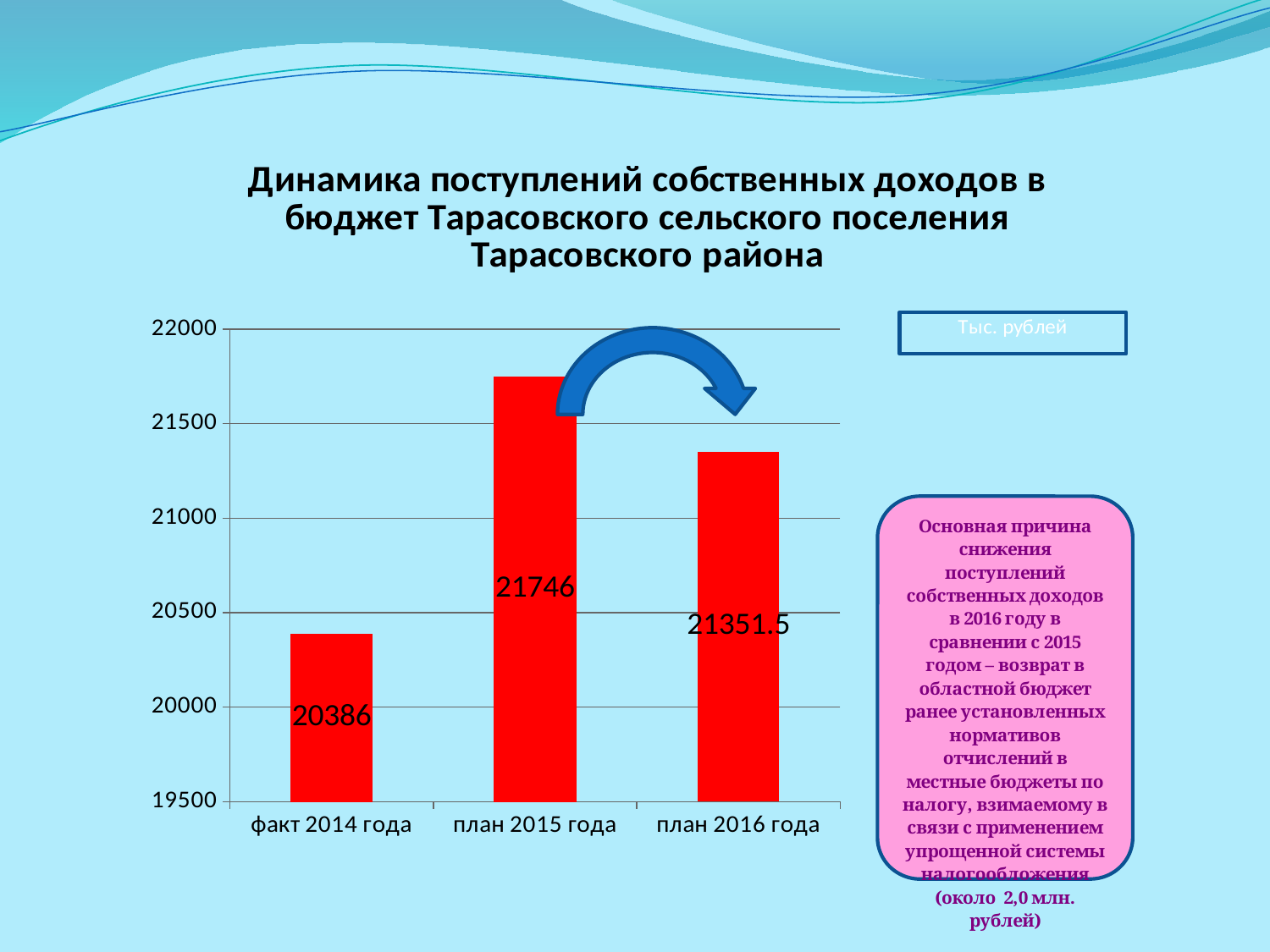
What unit of measurement is indicated for the chart values? Тыс. рублей Which is larger, the value for план 2016 года or the value for факт 2014 года? план 2016 года Which category has the lowest value? факт 2014 года How many categories are shown on the x axis? 3 What is the value for факт 2014 года? 20386 Which category has the highest value? план 2015 года Is the value for факт 2014 года greater or less than 20500? less What is the value for план 2016 года? 21351.5 What is the value for план 2015 года? 21746 What is the difference between the values for план 2015 года and факт 2014 года? 1360 What is the difference between the values for план 2015 года and план 2016 года? 394.5 What kind of chart is shown on the slide? bar chart